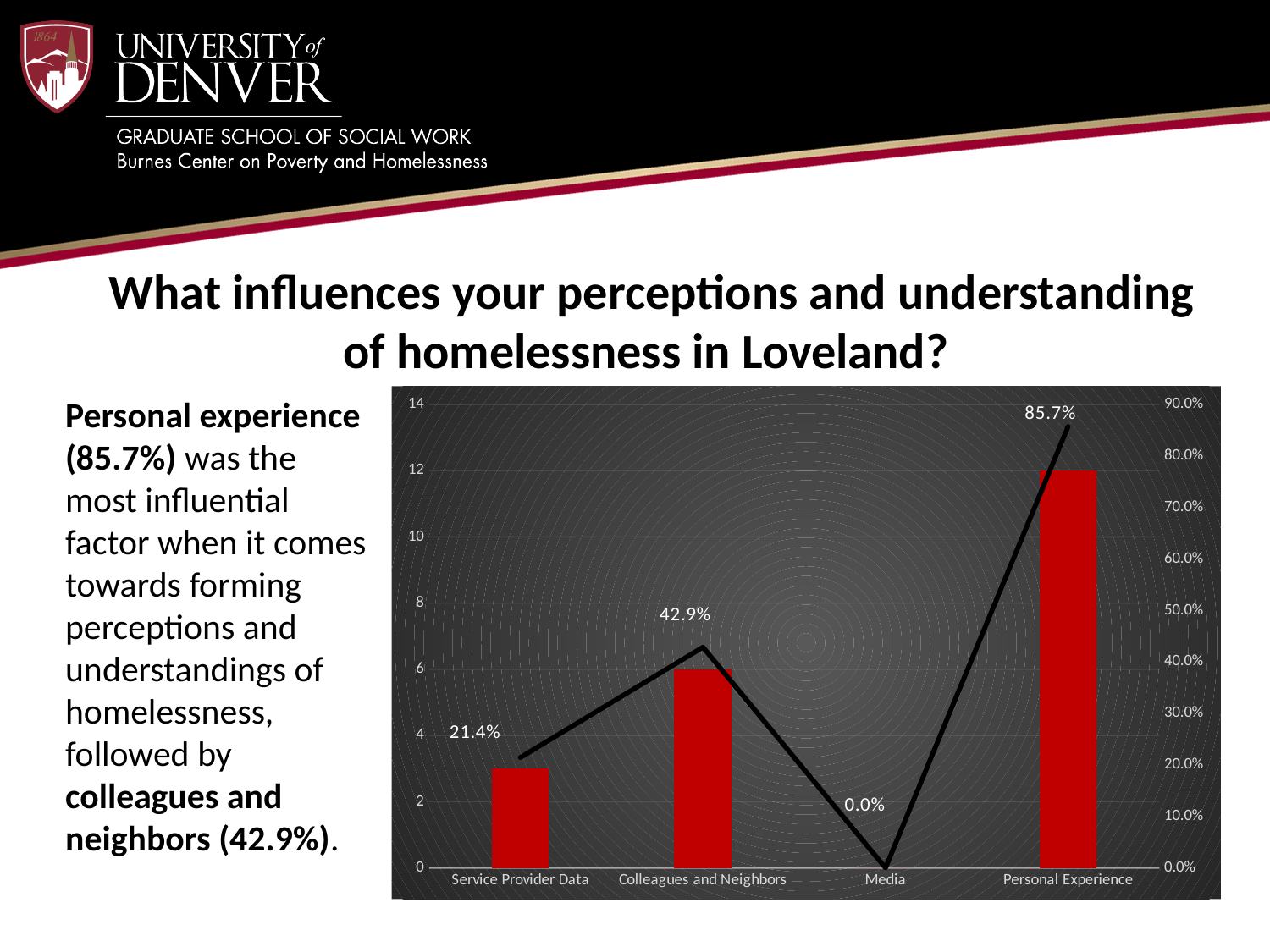
Which category has the lowest percentage? Media Which category has the highest percentage? Personal Experience What is the maximum value shown on the right-hand axis? 90.0% How many categories are shown on the x axis? 4 What is the difference in percentage points between Personal Experience and Colleagues and Neighbors? 42.8 Is the bar value for Service Provider Data on the left axis greater or less than 4? less What kind of chart is this? Combined bar and line chart Which has a higher percentage, Service Provider Data or Colleagues and Neighbors? Colleagues and Neighbors What percentage is shown for Media? 0.0% What percentage is shown for Colleagues and Neighbors? 42.9% What percentage is shown for Personal Experience? 85.7% What percentage is shown for Service Provider Data? 21.4%